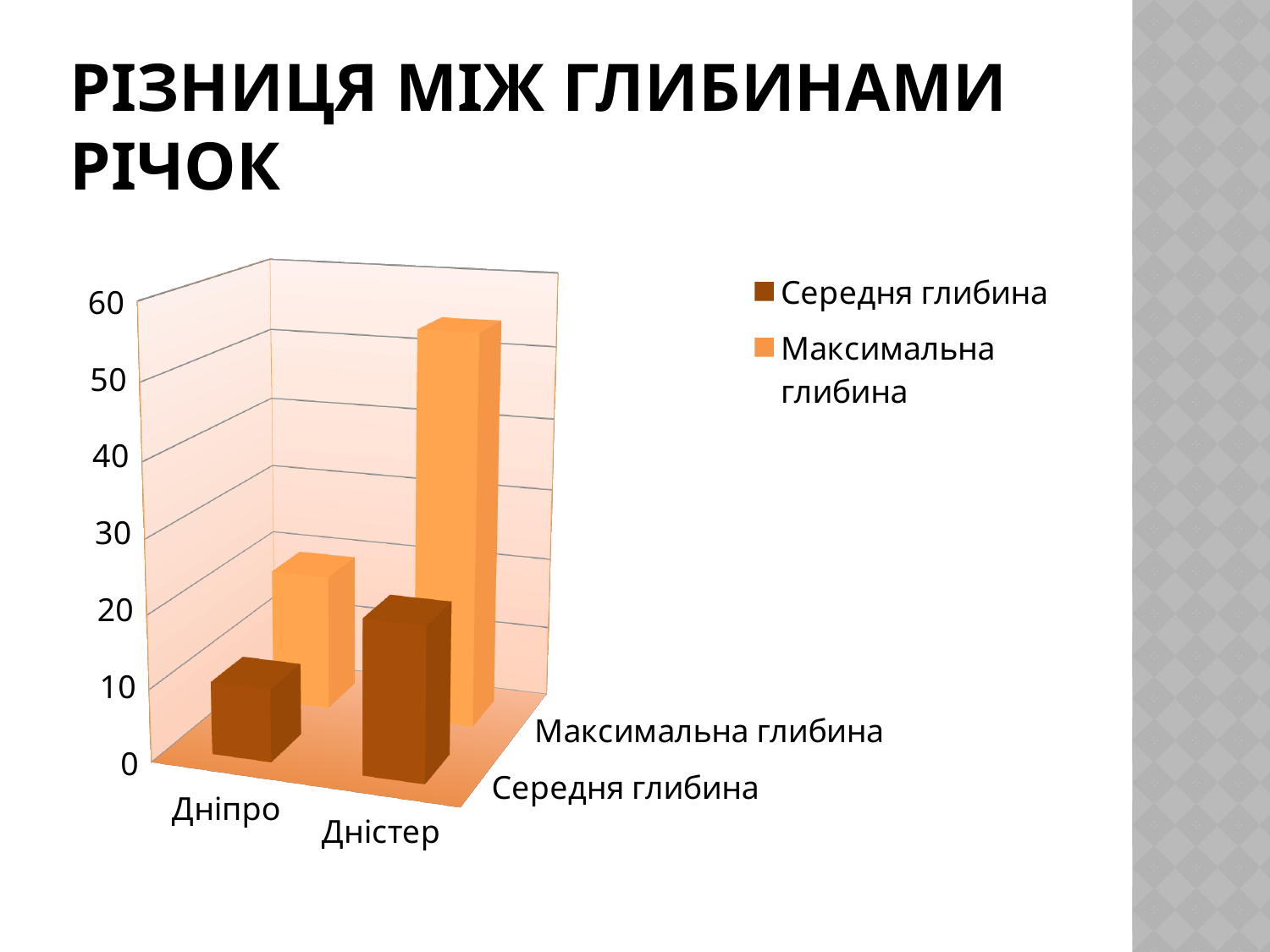
How many rivers (categories) are shown on the chart? 2 How many series does the legend list? 2 What kind of chart is shown on the slide? bar chart Which river has the tallest bar for Максимальна глибина? Дністер Which bar on the chart is the lowest overall? Середня глибина for Дніпро Is the value of Максимальна глибина for Дніпро greater or less than 10? greater Which series is shown in the darker brown colour in the legend? Середня глибина Which river has the larger Максимальна глибина, Дніпро or Дністер? Дністер What is the title of the chart on the slide? РІЗНИЦЯ МІЖ ГЛИБИНАМИ РІЧОК Is the value of Середня глибина for Дніпро greater or less than 20? less Which river has the larger Середня глибина, Дніпро or Дністер? Дністер Is the value of Максимальна глибина for Дністер greater or less than 40? greater